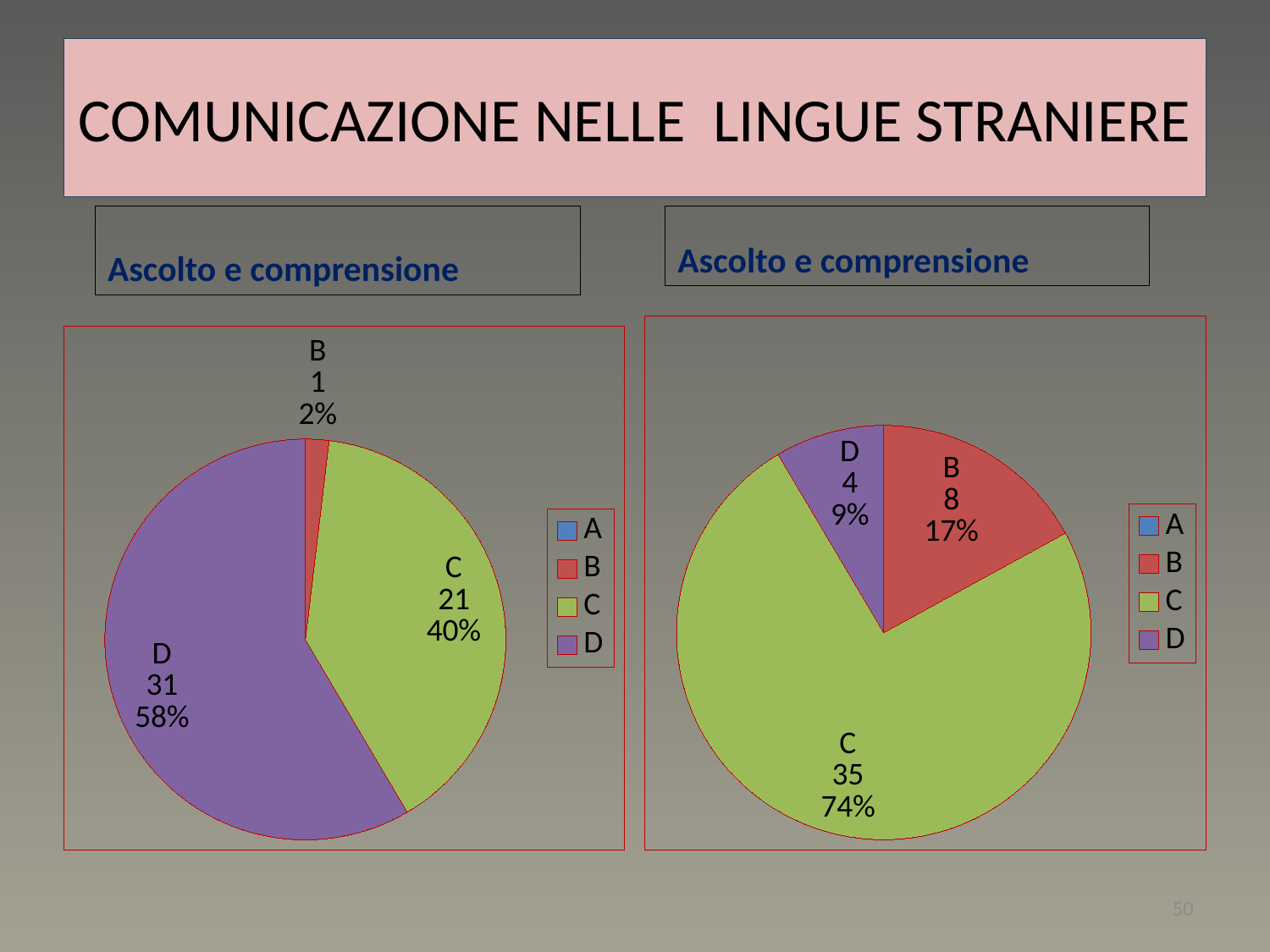
In the left pie chart, what percentage share does category C have? 40% In the left pie chart, what is the difference between the values for D and C? 10 In the right pie chart, which is larger, the value for B or the value for D? B In the right pie chart, what is the difference between the values for C and B? 27 In the right pie chart, what percentage share does category C have? 74% In the left pie chart, what is the value for category D? 31 In the left pie chart, which category has the largest slice? D In the right pie chart, which category has the smallest slice? D In the right pie chart, what is the value for category B? 8 How many entries does the legend of the left pie chart list? 4 What colour is the slice for category C in the right pie chart? green What type of chart is shown on the left of the slide? pie chart